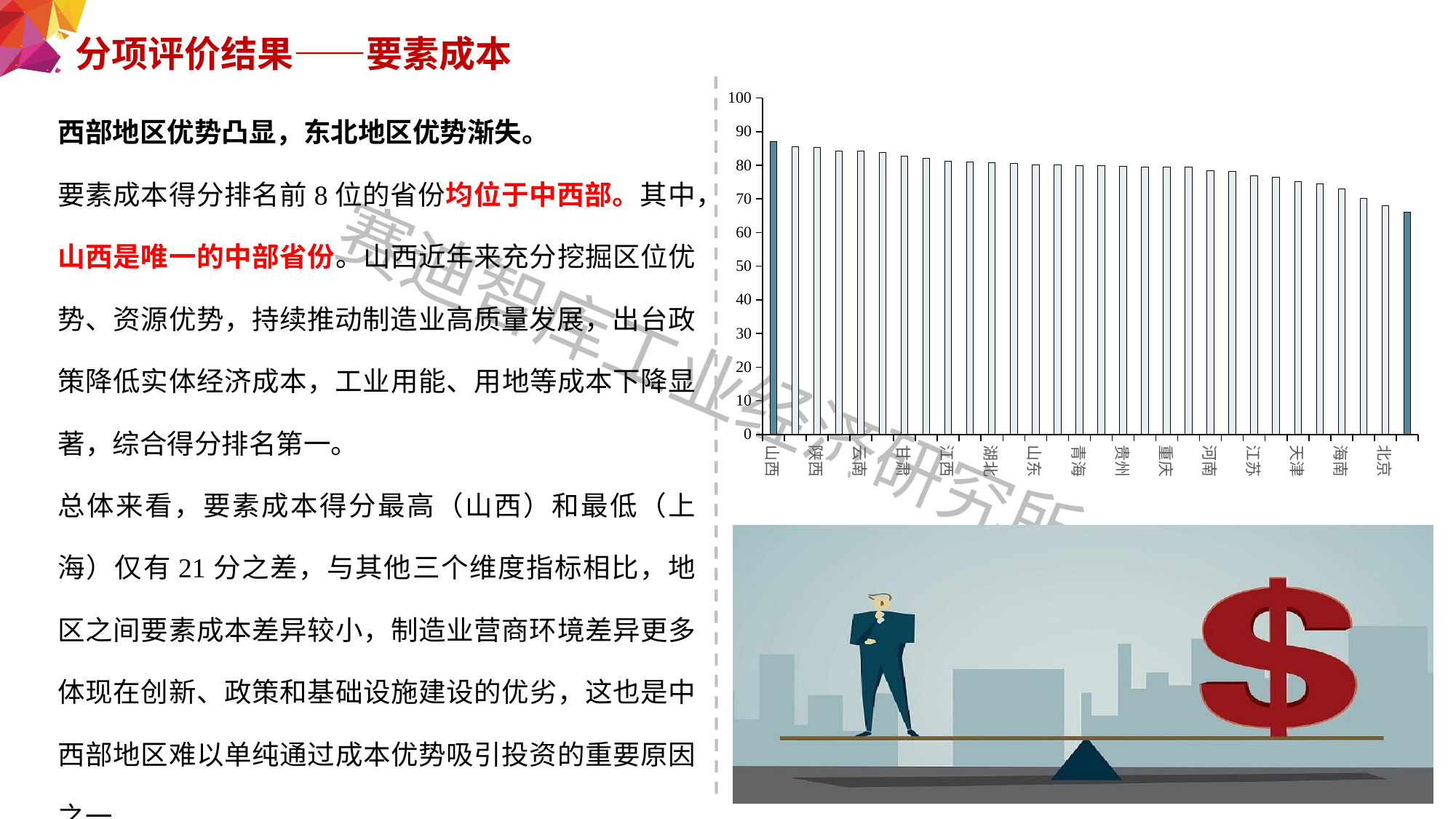
Is the value for 海南 greater or less than 80? less Is the value for 天津 greater or less than 80? less Which province has the highest value in the bar chart? 山西 Which is larger, the value for 陕西 or the value for 海南? 陕西 Is the value for 北京 greater or less than 80? less Do the bar values rise or fall from left to right along the x axis? fall What kind of chart is shown on the slide? bar chart Which is larger, the value for 山西 or the value for 北京? 山西 What is the maximum value shown on the y axis of the chart? 100